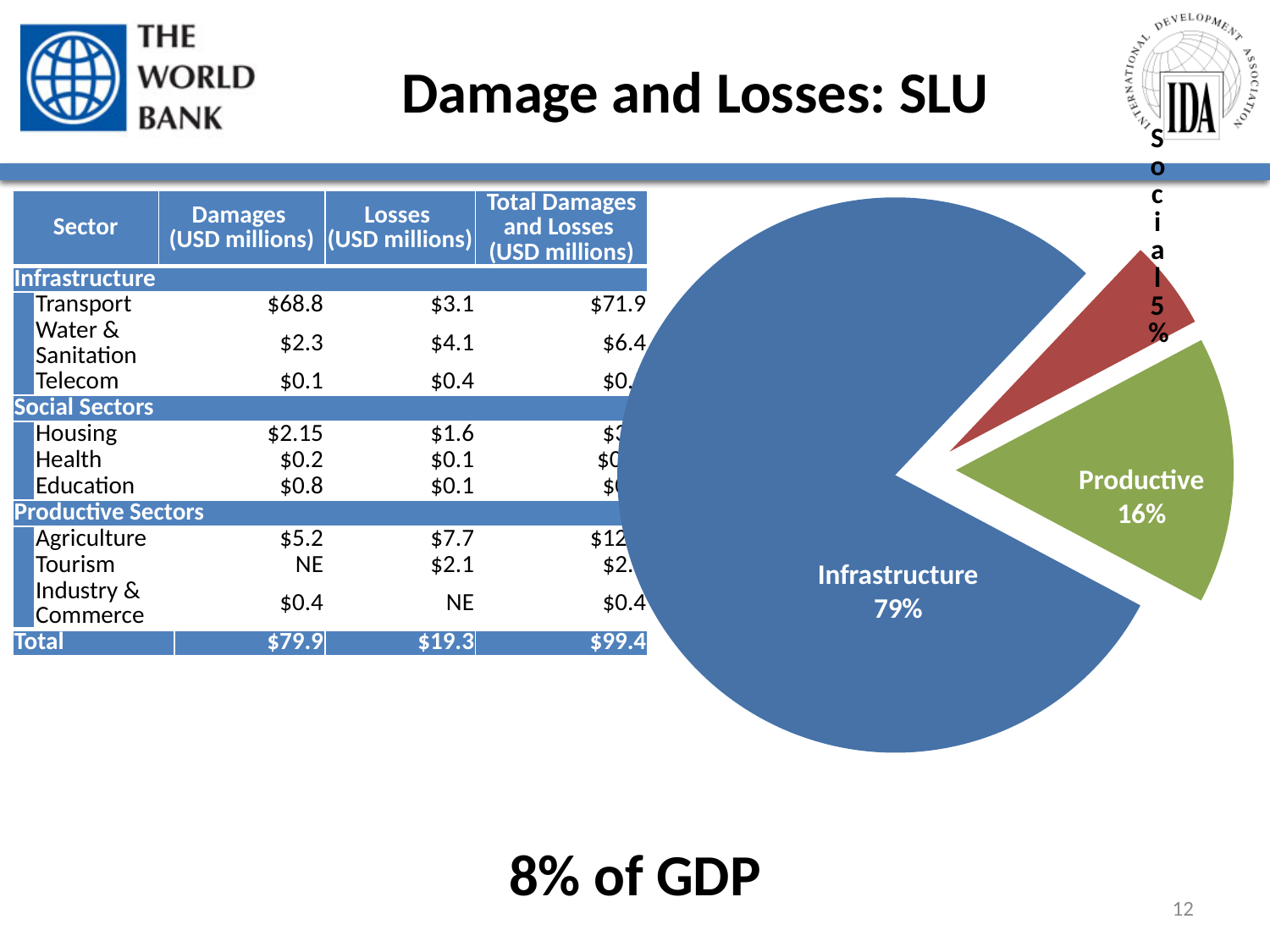
What share of the pie chart does Productive account for? 16% What is the difference in percentage points between the Productive and Social slices? 11 Which slice of the pie chart is the smallest? Social What share of the pie chart does Social account for? 5% How many slices does the pie chart have? 3 Which is larger in the pie chart, Productive or Social? Productive What share of the pie chart does Infrastructure account for? 79% What colour is the Productive slice of the pie chart? green What kind of chart is shown on the slide? pie chart Which slice of the pie chart is the largest? Infrastructure What colour is the Infrastructure slice of the pie chart? blue What is the difference in percentage points between the Infrastructure and Productive slices? 63